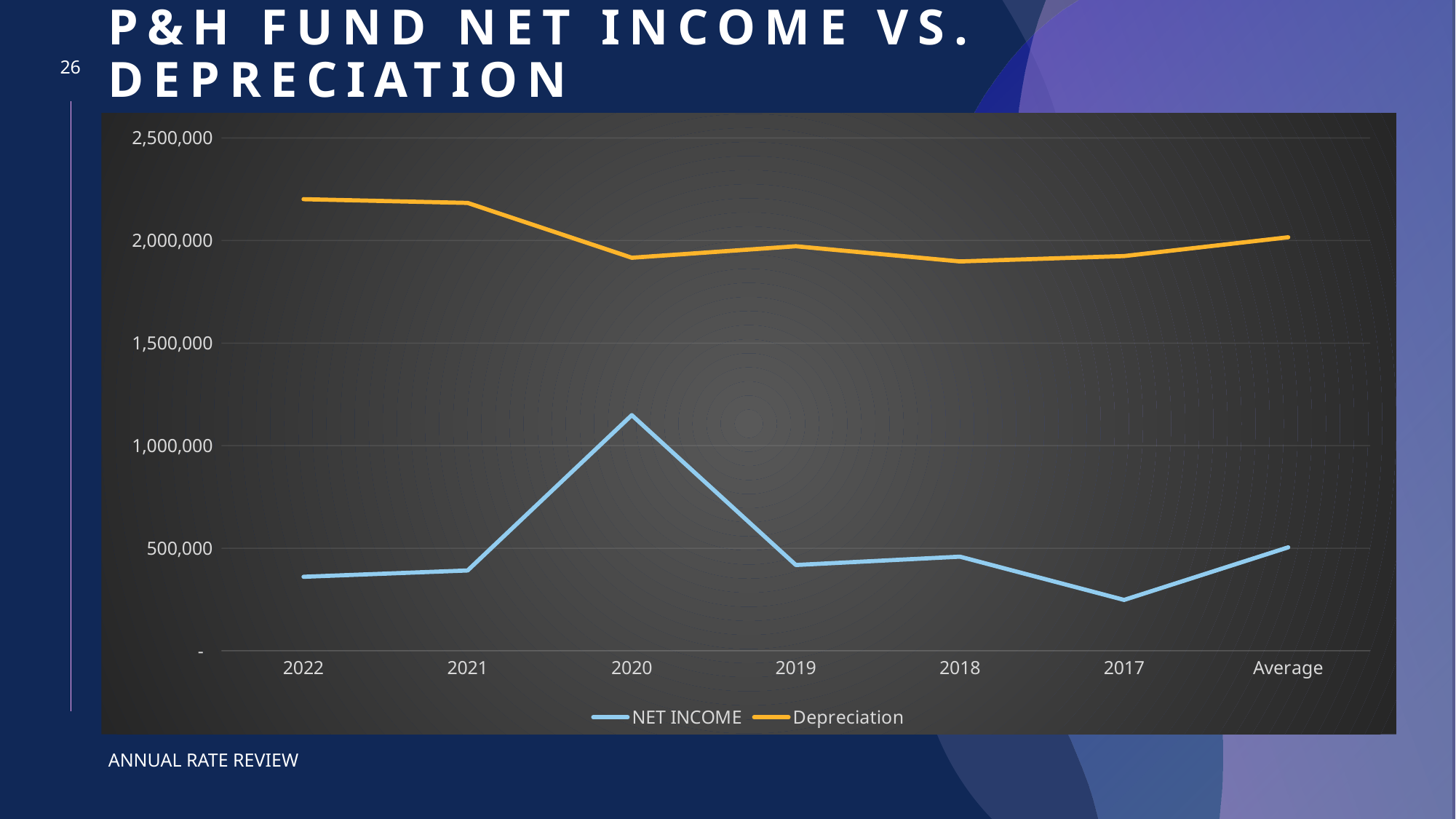
How many categories are shown along the x axis? 7 What kind of chart is shown on the slide? line chart Which is larger for NET INCOME: the value for 2020 or the value for 2019? 2020 Is the Depreciation value for 2018 greater or less than 2,000,000? less In 2019, which is larger: NET INCOME or Depreciation? Depreciation Is the NET INCOME value for 2020 greater or less than 1,000,000? greater What is the title of the chart on the slide? P&H FUND NET INCOME VS. DEPRECIATION Is the NET INCOME value for 2017 greater or less than 500,000? less In which year is NET INCOME highest? 2020 In which year is NET INCOME lowest? 2017 How many series does the legend list? 2